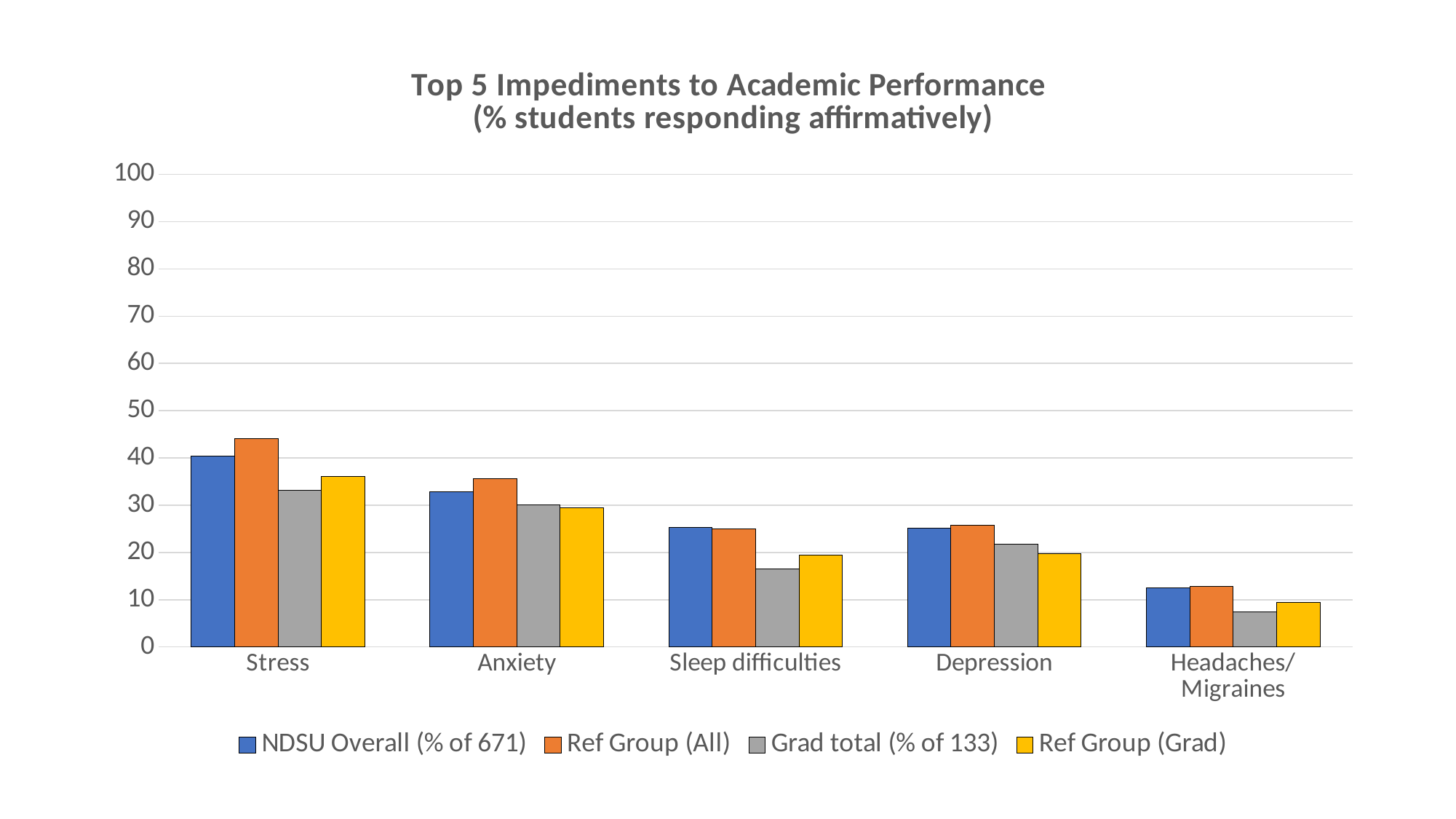
For the Grad total (% of 133) series, which category has the lowest value? Headaches/Migraines How many series does the legend list? 4 Is the Ref Group (All) value for Stress greater or less than 40? greater How many impediment categories are shown on the x axis? 5 Do the NDSU Overall (% of 671) values rise or fall moving from Stress to Headaches/Migraines along the x axis? fall For Sleep difficulties, which is larger: the Grad total (% of 133) value or the Ref Group (Grad) value? Ref Group (Grad) For Stress, which is larger: the NDSU Overall (% of 671) value or the Ref Group (All) value? Ref Group (All) What kind of chart is shown on the slide? bar chart What colour represents the Ref Group (Grad) series in the legend? yellow Is the Grad total (% of 133) value for Sleep difficulties greater or less than 20? less Is the NDSU Overall (% of 671) value for Anxiety greater or less than 30? greater For the Ref Group (All) series, which category has the highest value? Stress